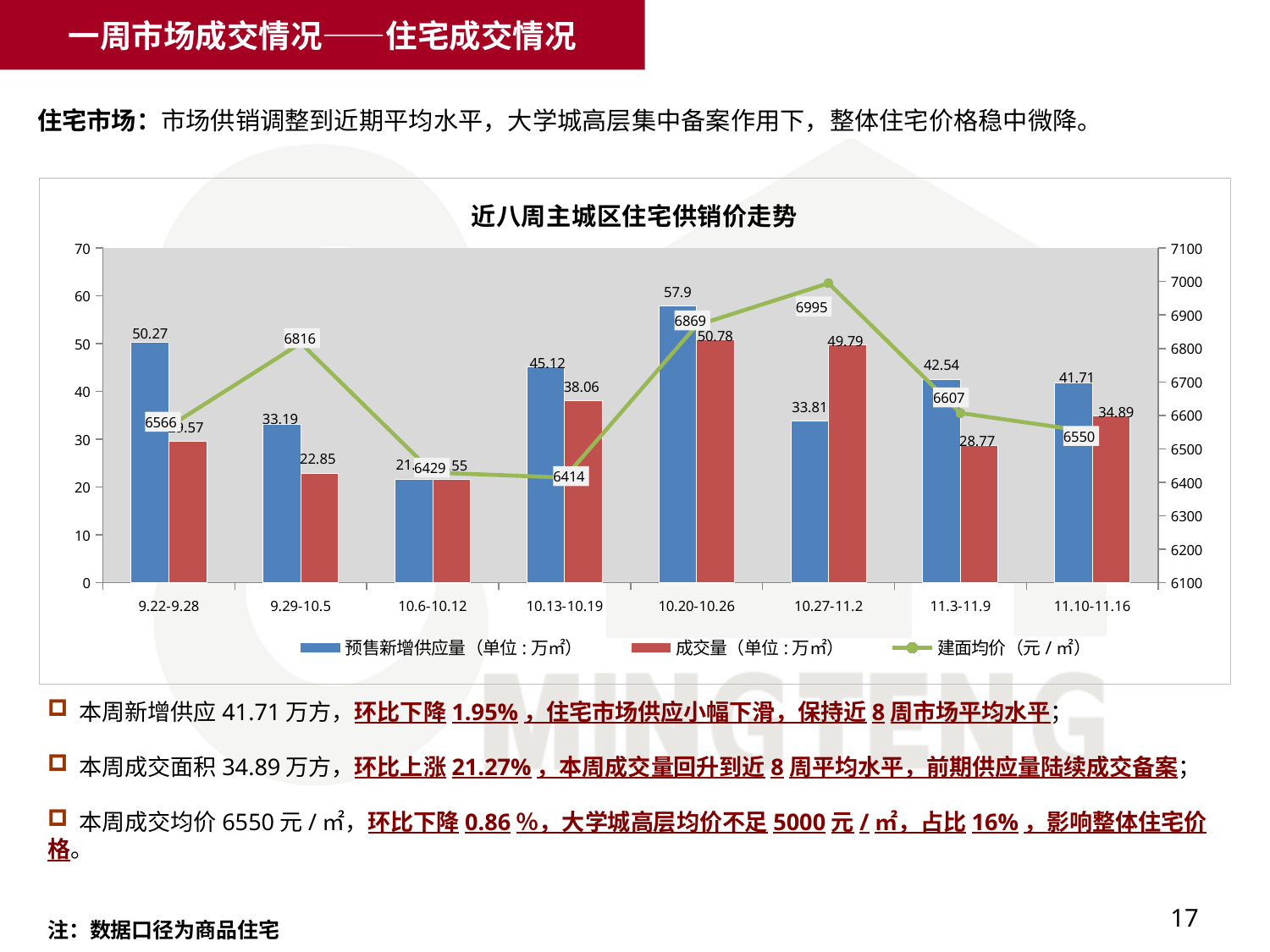
What is the 成交量 value for the week 11.10-11.16? 34.89 How many weekly periods are shown on the x axis of the chart? 8 What is the 建面均价 value for the week 10.27-11.2? 6995 What kind of chart is shown on the slide? A combined bar and line chart Which week has the larger 成交量: 10.20-10.26 or 10.27-11.2? 10.20-10.26 How many series does the chart legend list? 3 What is the difference between the 预售新增供应量 for 10.20-10.26 and for 11.10-11.16? 16.19 In which week is the 建面均价 highest? 10.27-11.2 In which week is the 预售新增供应量 highest? 10.20-10.26 What is the 预售新增供应量 value for the week 10.20-10.26? 57.9 In which week is the 建面均价 lowest? 10.13-10.19 What is the difference between the 建面均价 for 10.27-11.2 and for 11.10-11.16? 445